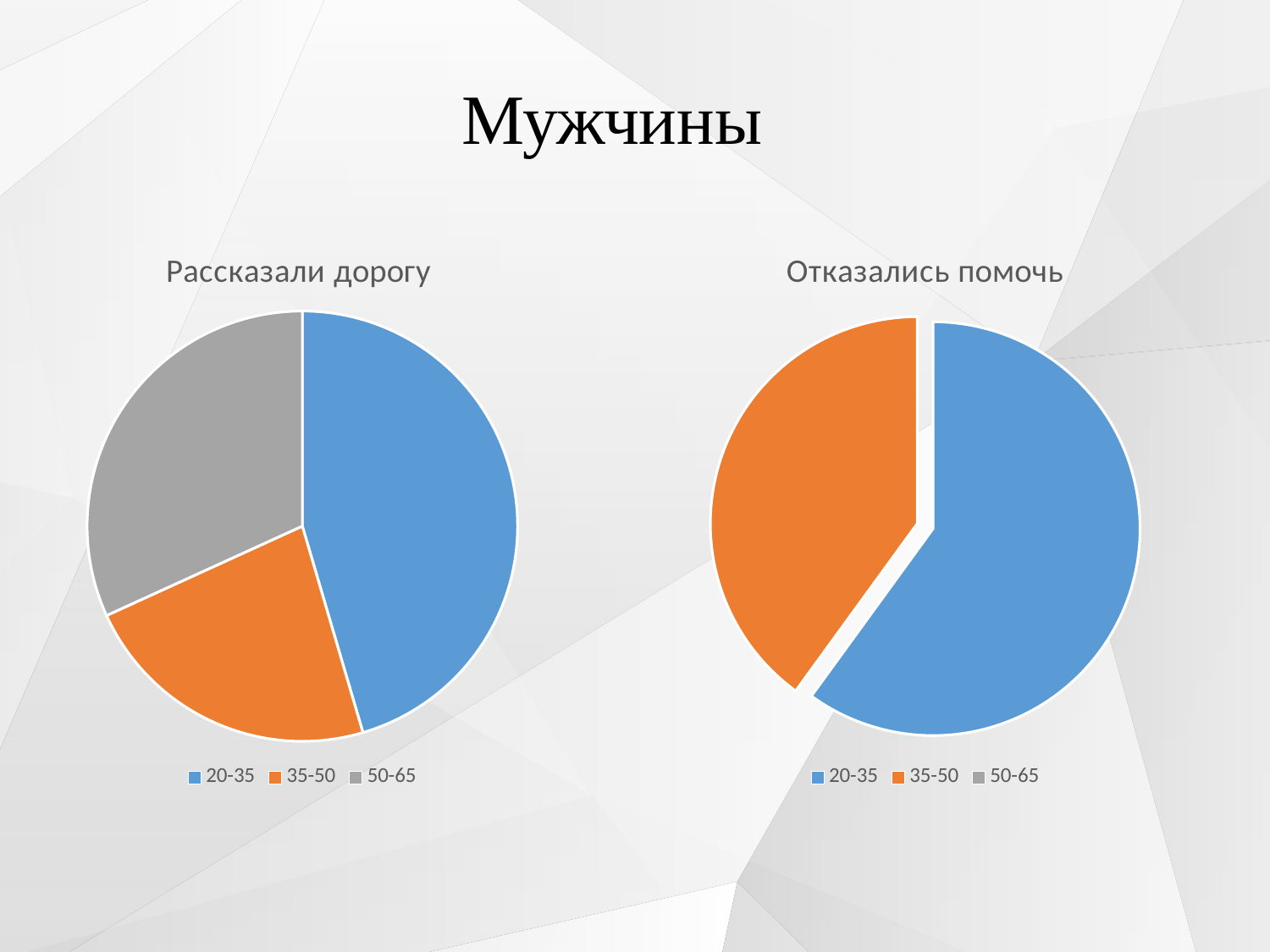
How many slices are visible in the chart titled "Рассказали дорогу"? 3 What kind of chart is the chart titled "Рассказали дорогу"? pie chart In the chart titled "Рассказали дорогу", which slice is larger: 50-65 or 35-50? 50-65 How many entries does the legend of the chart titled "Рассказали дорогу" list? 3 In the chart titled "Рассказали дорогу", which colour represents the 50-65 age group? gray In the chart titled "Рассказали дорогу", which age group has the smallest slice? 35-50 In the chart titled "Отказались помочь", which age group has the largest slice? 20-35 In the chart titled "Отказались помочь", which slice is larger: 20-35 or 35-50? 20-35 In the chart titled "Рассказали дорогу", which age group has the largest slice? 20-35 What kind of chart is the chart titled "Отказались помочь"? pie chart How many slices are visible in the chart titled "Отказались помочь"? 2 What is the title of the pie chart on the right side of the slide? Отказались помочь